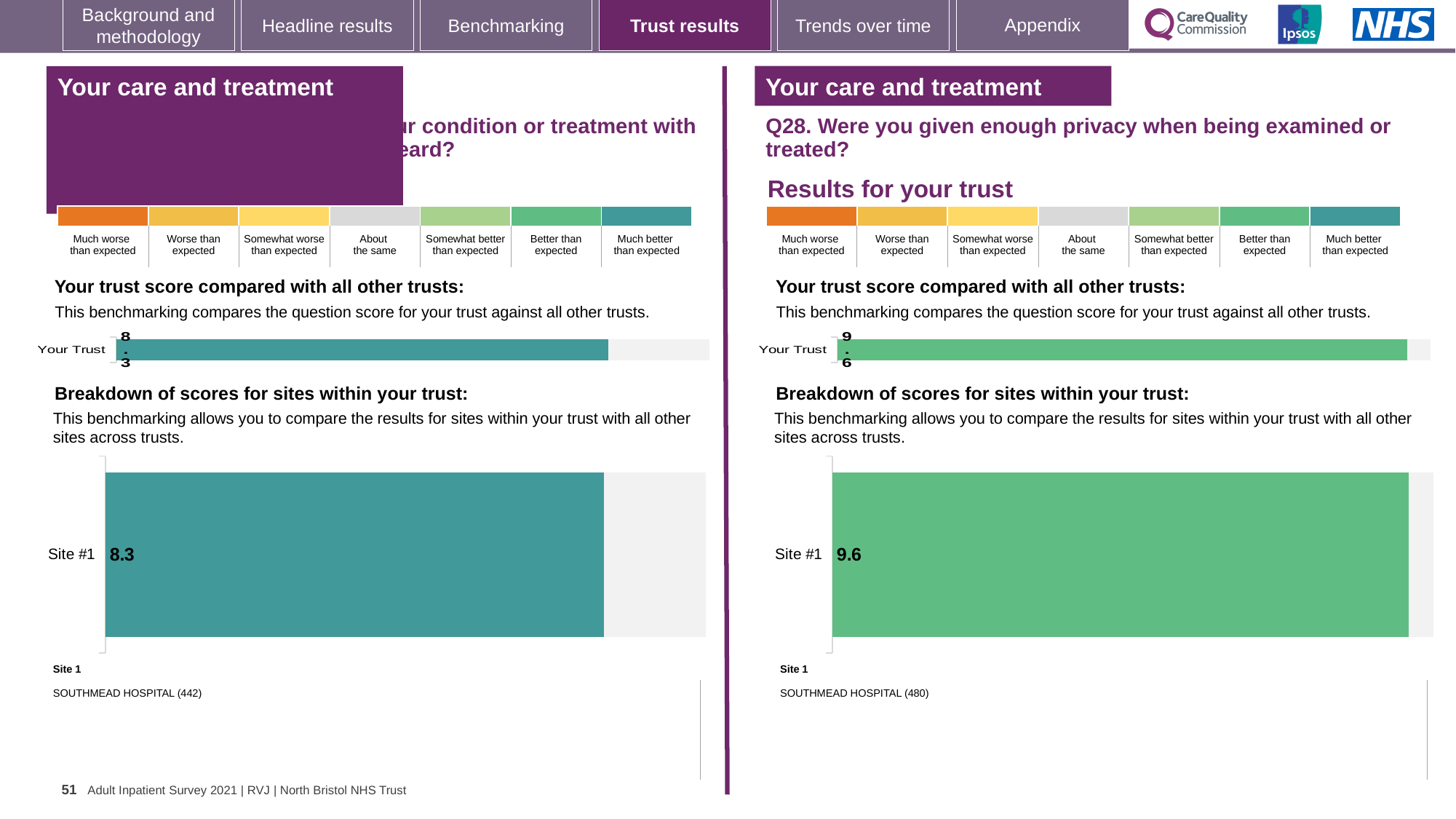
On the right-hand chart for Q28, what is the score shown for Your Trust? 9.6 What is the difference between the Site #1 score on the right-hand chart for Q28 and the Site #1 score on the left-hand chart? 1.3 What type of chart is used to show the breakdown of scores for sites within your trust on the right-hand panel? Bar chart On the left-hand panel, which hospital is listed as Site 1? SOUTHMEAD HOSPITAL (442) On the right-hand chart for Q28, what is the score shown for Site #1? 9.6 On the left-hand chart, what is the score shown for Site #1? 8.3 How many sites are shown in the breakdown of scores chart on the right-hand panel for Q28? 1 Is the Your Trust score on the right-hand chart for Q28 greater or less than the Your Trust score on the left-hand chart? greater On the right-hand panel for Q28, which hospital is listed as Site 1? SOUTHMEAD HOSPITAL (480) Which is larger: the Site #1 score on the left-hand chart or the Site #1 score on the right-hand chart for Q28? Right-hand chart (Q28) How many sites are shown in the breakdown of scores chart on the left-hand panel? 1 On the left-hand chart, what is the score shown for Your Trust? 8.3